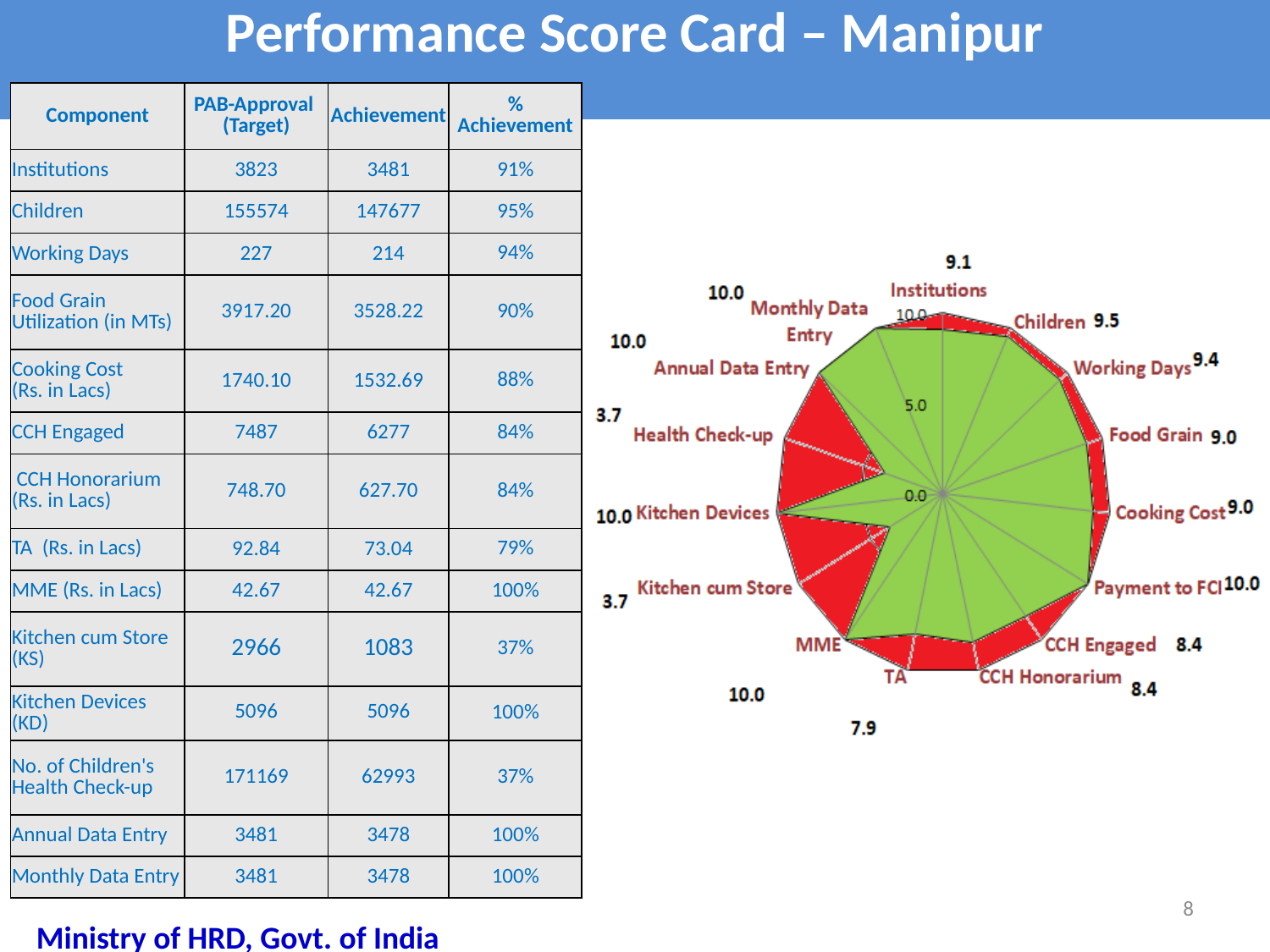
What kind of chart is shown on the right side of the slide? Radar chart How many categories are plotted around the radar chart? 15 In the radar chart, is the value for Health Check-up greater or less than 5.0? less In the radar chart, what is the value for Payment to FCI? 10.0 What is the highest tick value shown on the radar chart's axis? 10.0 In the radar chart, what is the difference between the values for Children and TA? 1.6 In the radar chart, what is the value for Children? 9.5 In the radar chart, which has the larger value, Working Days or Health Check-up? Working Days In the radar chart, what is the value for Kitchen cum Store? 3.7 In the radar chart, what is the value for Institutions? 9.1 In the radar chart, what is the value for CCH Engaged? 8.4 In the radar chart, what is the value for TA? 7.9